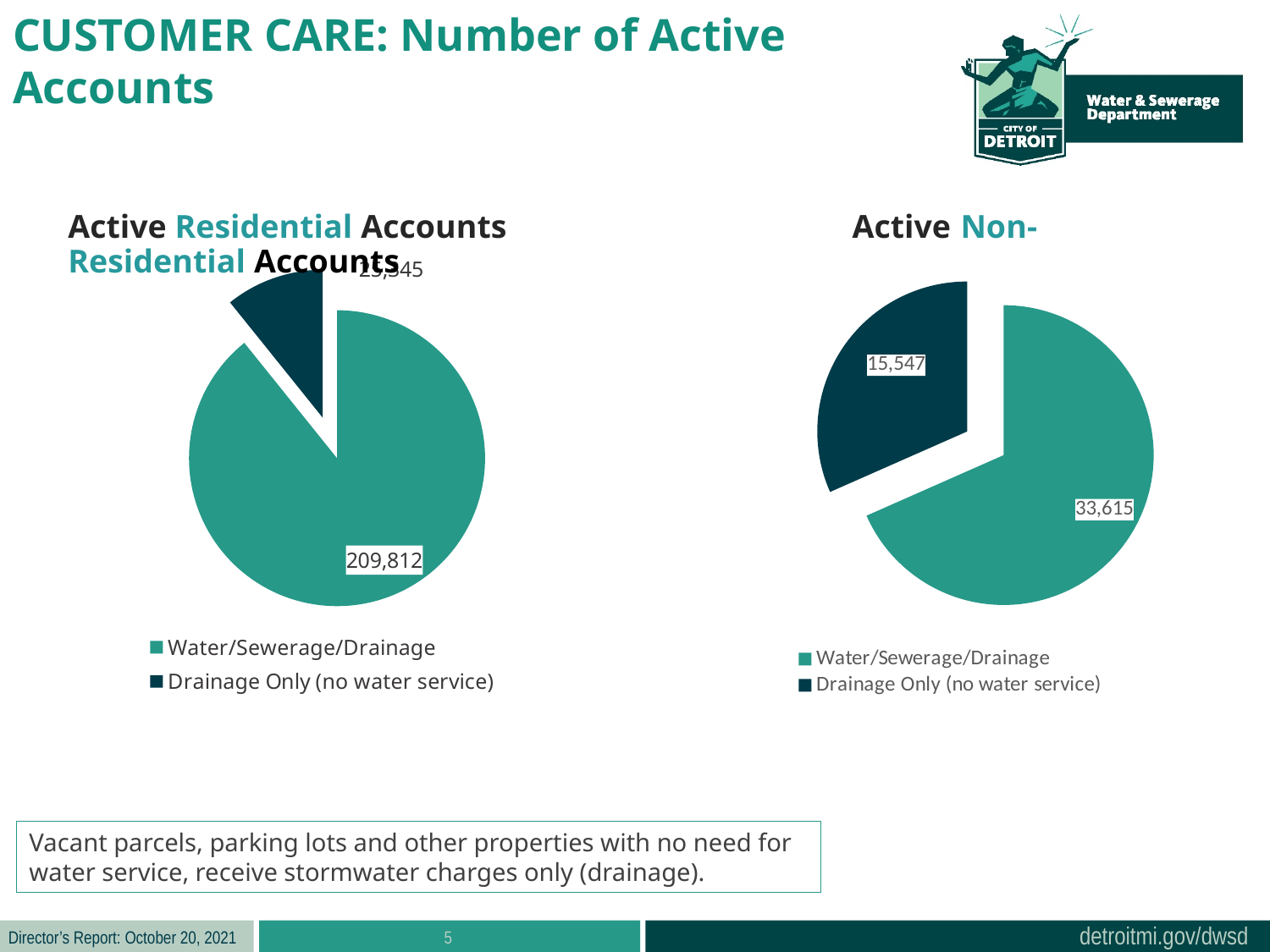
How many entries does the legend of the Active Non-Residential Accounts chart list? 2 In the Active Residential Accounts chart, which category has the largest slice? Water/Sewerage/Drainage In the Active Non-Residential Accounts chart, which category has the smallest slice? Drainage Only (no water service) How many slices does the Active Residential Accounts pie chart have? 2 In the Active Non-Residential Accounts chart, what is the total of the two slices? 49,162 In the Active Non-Residential Accounts chart, which is larger: Water/Sewerage/Drainage or Drainage Only (no water service)? Water/Sewerage/Drainage In the Active Non-Residential Accounts chart, what is the difference between Water/Sewerage/Drainage and Drainage Only (no water service)? 18,068 What type of chart is used for Active Residential Accounts? Pie chart In the Active Residential Accounts chart, which colour represents Drainage Only (no water service)? Dark teal (dark blue-green) In the Active Non-Residential Accounts chart, what is the value for Drainage Only (no water service)? 15,547 In the Active Non-Residential Accounts chart, what is the value for Water/Sewerage/Drainage? 33,615 In the Active Residential Accounts chart, what is the value for Water/Sewerage/Drainage? 209,812